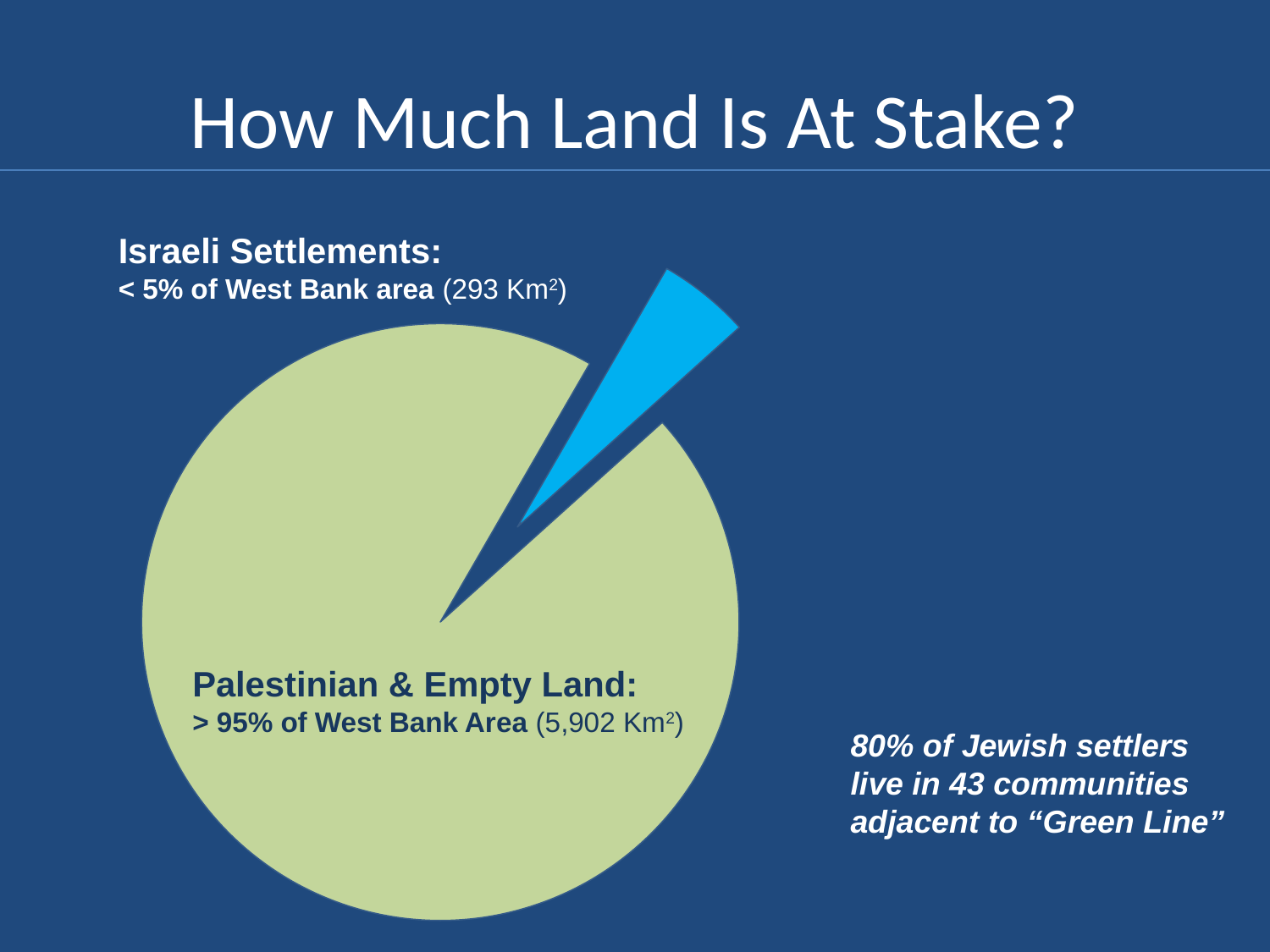
What colour is the Israeli Settlements slice of the pie chart? blue Which is larger in area: Israeli Settlements or Palestinian & Empty Land? Palestinian & Empty Land What share of the West Bank area is labelled for Palestinian & Empty Land? > 95% How many slices does the pie chart have? 2 Which slice of the pie chart is the largest? Palestinian & Empty Land What share of the West Bank area is labelled for Israeli Settlements? < 5% What area in Km² is given for Israeli Settlements? 293 Km² Which slice of the pie chart is the smallest? Israeli Settlements What is the title of the slide containing the pie chart? How Much Land Is At Stake? What area in Km² is given for Palestinian & Empty Land? 5,902 Km² What kind of chart is shown on the slide? pie chart What is the difference in Km² between the Palestinian & Empty Land area and the Israeli Settlements area? 5,609 Km²